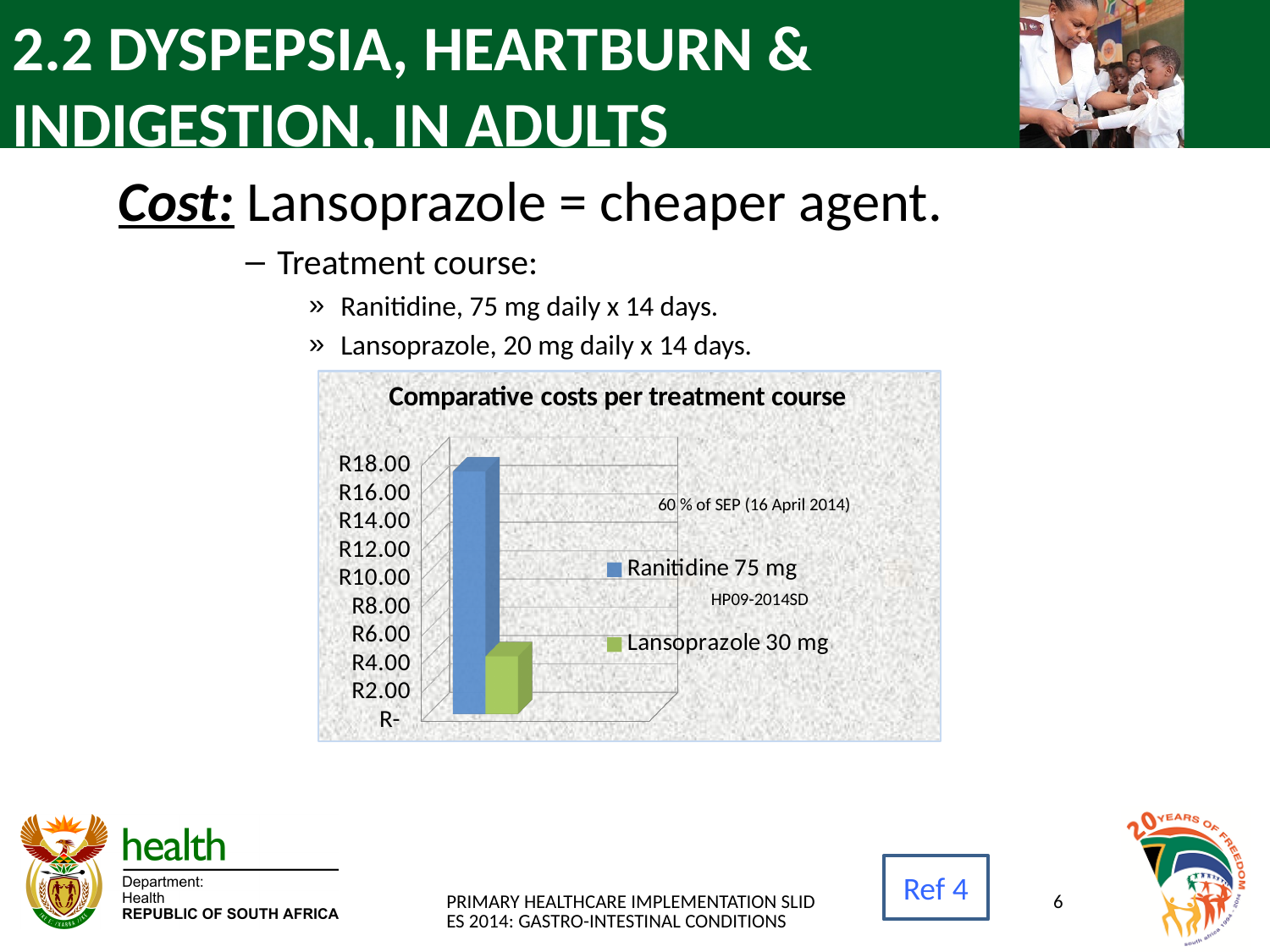
Is the value for Ranitidine 75 mg greater or less than R14.00? greater Which is larger, the cost for Ranitidine 75 mg or for Lansoprazole 30 mg? Ranitidine 75 mg What kind of chart is shown on the slide? bar chart What is the title of the chart? Comparative costs per treatment course Is the value for Lansoprazole 30 mg greater or less than R6.00? less What colour is the bar for Lansoprazole 30 mg? green What is the highest value shown on the vertical axis of the chart? R18.00 Which series has the lowest cost per treatment course? Lansoprazole 30 mg Which series has the highest cost per treatment course? Ranitidine 75 mg Is the value for Lansoprazole 30 mg greater or less than R2.00? greater How many series does the chart legend list? 2 How many bars are plotted in the chart? 2